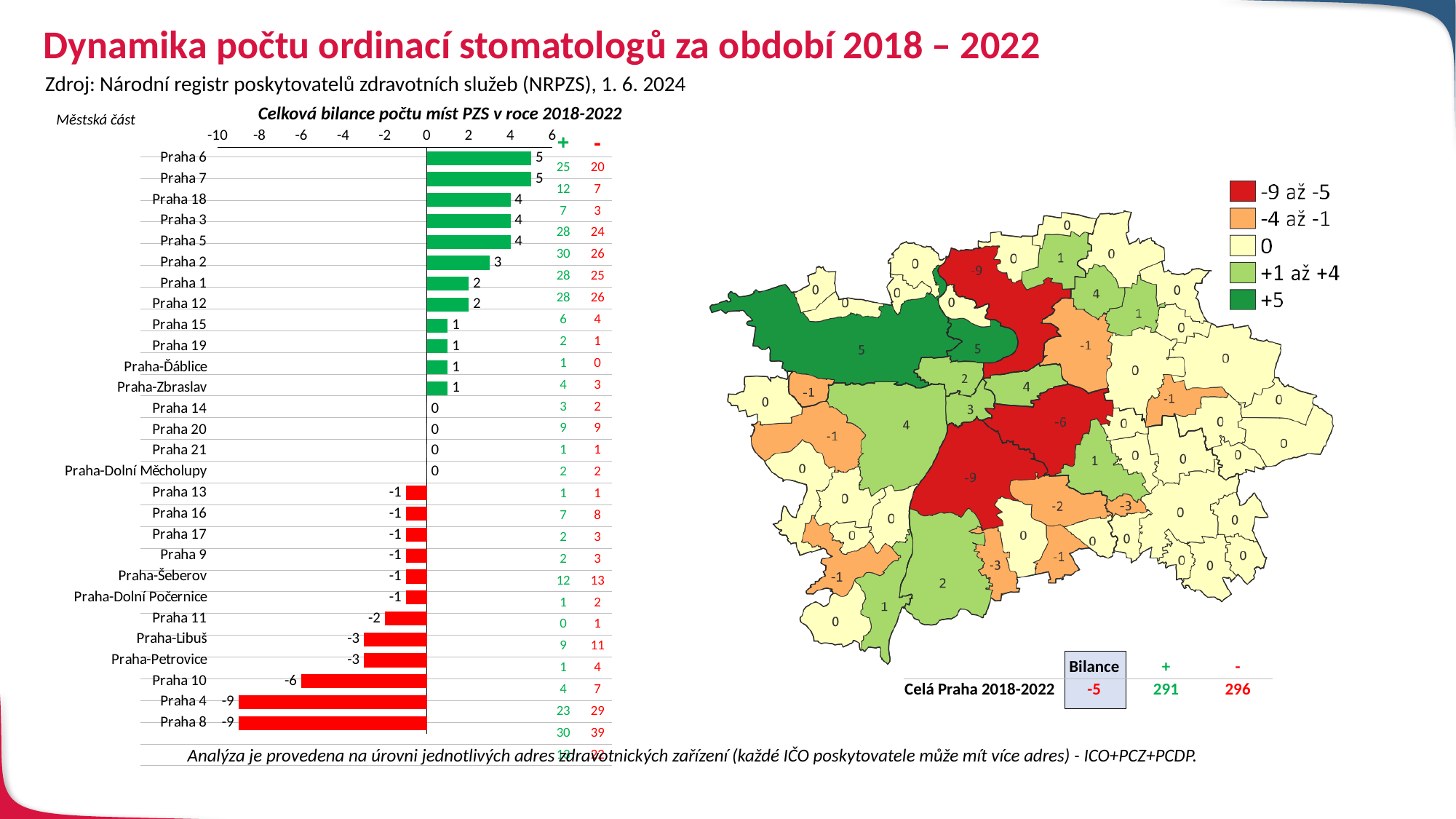
What is the value for Praha 10 in the bar chart? -6 What is the value for Praha-Libuš in the bar chart? -3 What is the value for Praha 18 in the bar chart? 4 Which has the larger value in the bar chart, Praha 5 or Praha 12? Praha 5 Which has the larger value in the bar chart, Praha 4 or Praha-Petrovice? Praha-Petrovice How many city districts (categories) are shown in the bar chart? 28 What is the difference between the values for Praha 6 and Praha 8 in the bar chart? 14 What is the title of the bar chart? Celková bilance počtu míst PZS v roce 2018-2022 What is the value for Praha-Zbraslav in the bar chart? 1 What is the difference between the values for Praha 1 and Praha 11 in the bar chart? 4 What is the value for Praha 2 in the bar chart? 3 What kind of chart is used to show the balance of PZS places by city district? bar chart